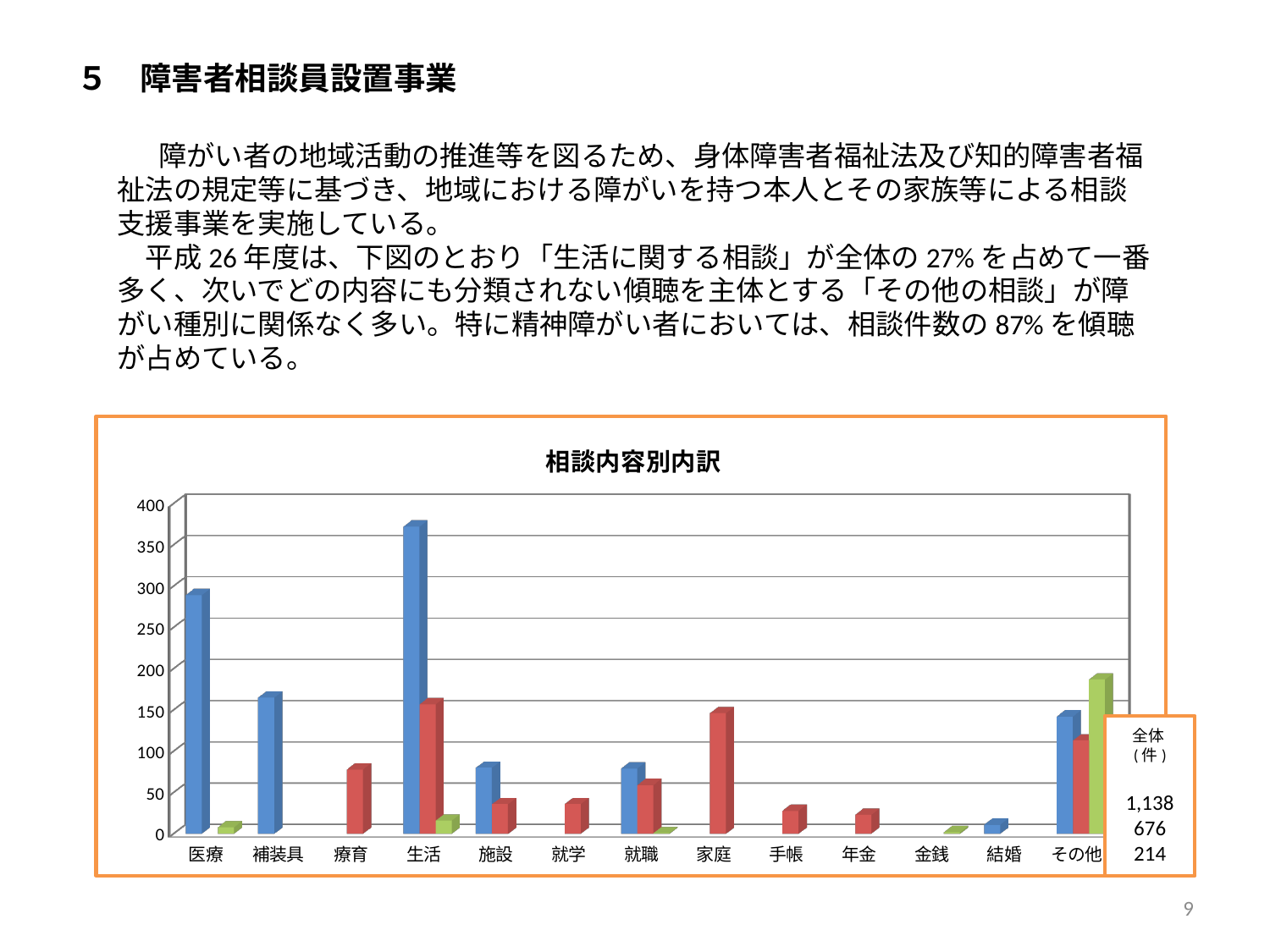
Is the blue bar for 生活 greater or less than 350? greater Which has the larger red bar, 療育 or 就学? 療育 Is the blue bar for 施設 greater or less than 100? less How many categories are shown on the x axis of the chart? 13 Which has the larger blue bar, 医療 or 補装具? 医療 What kind of chart is shown on the slide? bar chart Which category has the tallest blue bar? 生活 Is the red bar for 家庭 greater or less than 100? greater Which category has the tallest green bar? その他 What is the title of the chart? 相談内容別内訳